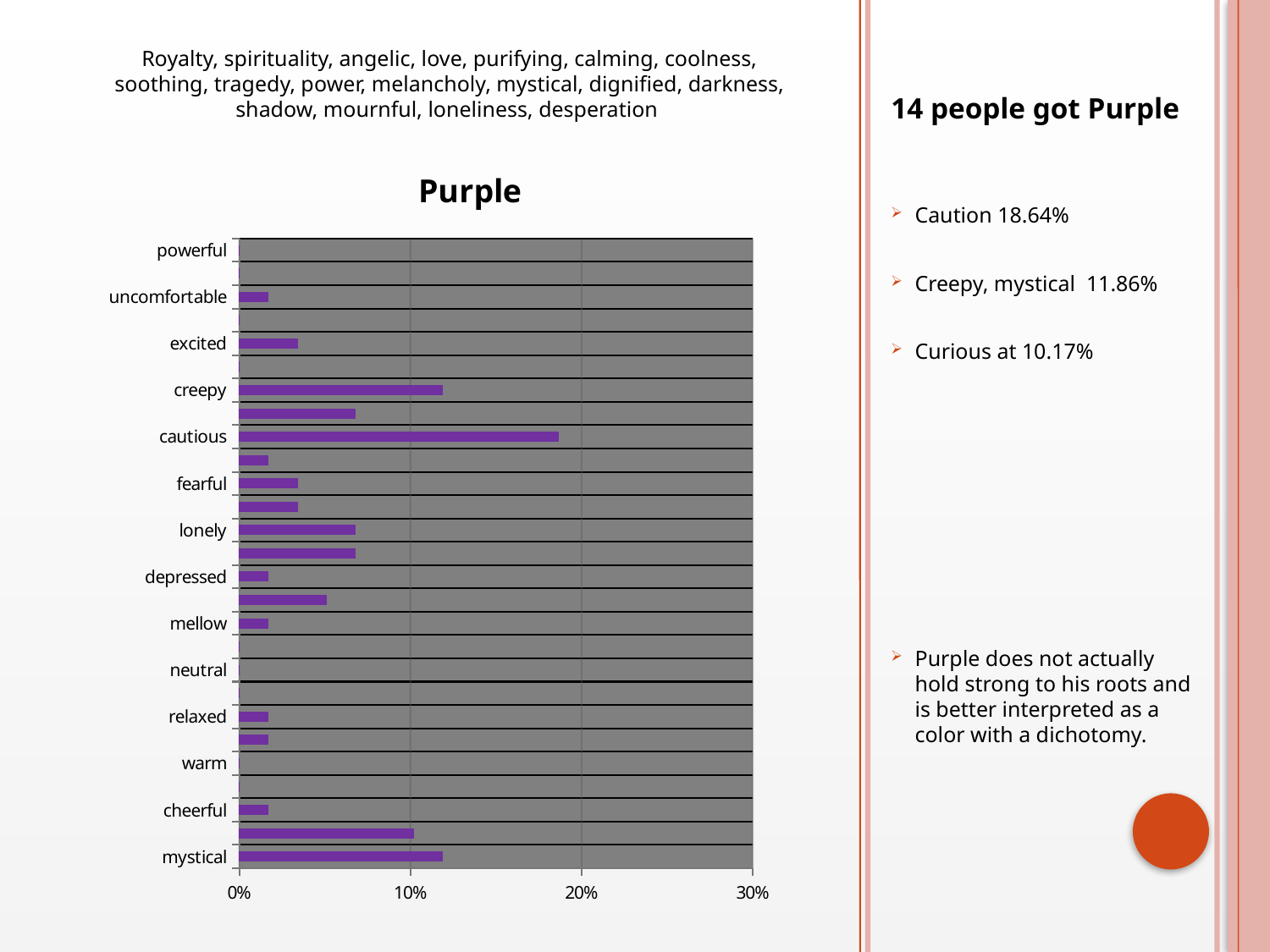
Which has the larger value, lonely or depressed? lonely What is the title of the chart? Purple How many category labels are shown on the vertical axis of the chart? 14 Which has the larger value, cautious or creepy? cautious What kind of chart is shown on the slide? bar chart Is the value for excited greater or less than 10%? less What is the highest value shown on the horizontal axis of the chart? 30% Which has the larger value, excited or uncomfortable? excited Is the value for cautious greater or less than 10%? greater Is the value for lonely greater or less than 10%? less Which labeled category has the longest bar in the chart? cautious